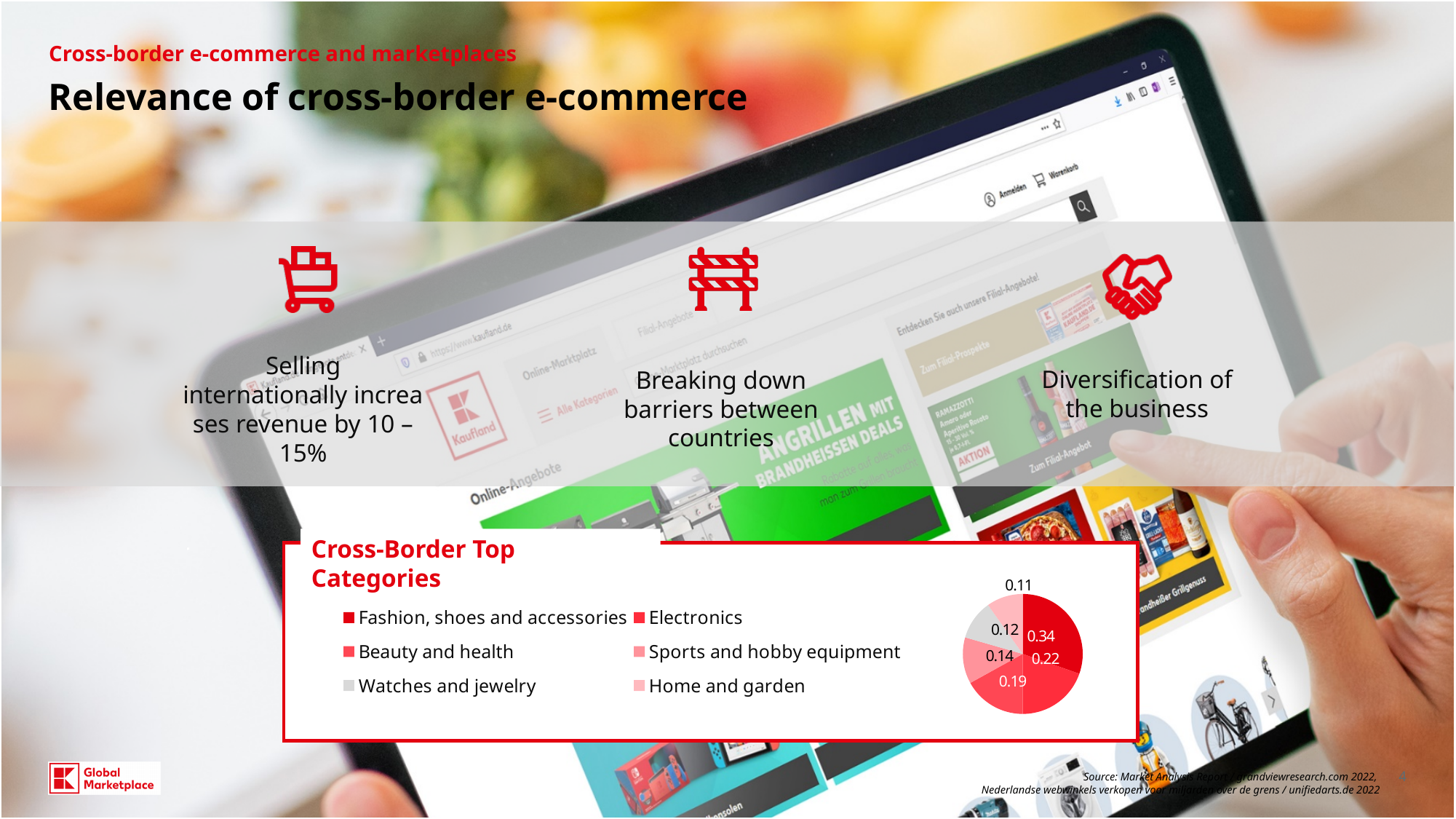
Which category has the smallest slice in the Cross-Border Top Categories pie chart? Home and garden What is the value for Sports and hobby equipment in the Cross-Border Top Categories pie chart? 0.14 In the Cross-Border Top Categories pie chart, which is larger: Beauty and health or Sports and hobby equipment? Beauty and health What is the value for Fashion, shoes and accessories in the Cross-Border Top Categories pie chart? 0.34 What is the value for Electronics in the Cross-Border Top Categories pie chart? 0.22 How many categories does the legend of the Cross-Border Top Categories pie chart list? 6 What is the value for Home and garden in the Cross-Border Top Categories pie chart? 0.11 In the Cross-Border Top Categories pie chart, what is the difference between the values for Fashion, shoes and accessories and Electronics? 0.12 What is the title of the pie chart on the slide? Cross-Border Top Categories Which category has the largest slice in the Cross-Border Top Categories pie chart? Fashion, shoes and accessories What is the value for Beauty and health in the Cross-Border Top Categories pie chart? 0.19 What type of chart is shown under "Cross-Border Top Categories"? Pie chart